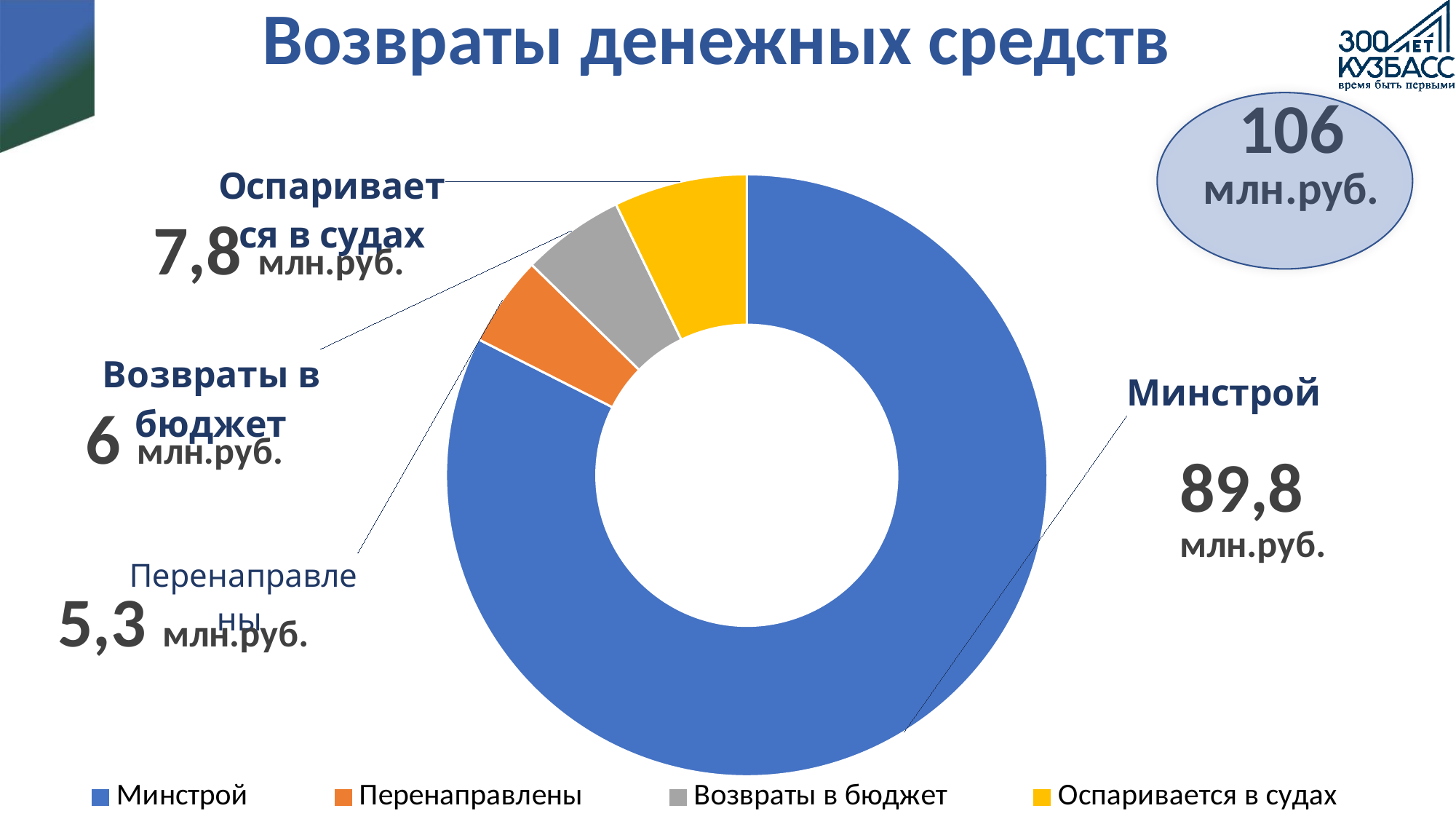
How many categories does the chart show? 4 What is the title of the slide? Возвраты денежных средств Which is larger, Возвраты в бюджет or Перенаправлены? Возвраты в бюджет Which category has the smallest value? Перенаправлены What value is shown for Перенаправлены? 5,3 млн.руб. What is the difference between the values for Оспаривается в судах and Возвраты в бюджет? 1,8 млн.руб. Which category has the largest value? Минстрой What value is shown for Минстрой? 89,8 млн.руб. What value is shown for Оспаривается в судах? 7,8 млн.руб. What is the difference between the values for Минстрой and Оспаривается в судах? 82 млн.руб. What kind of chart is shown on the slide? Doughnut (pie) chart What value is shown for Возвраты в бюджет? 6 млн.руб.